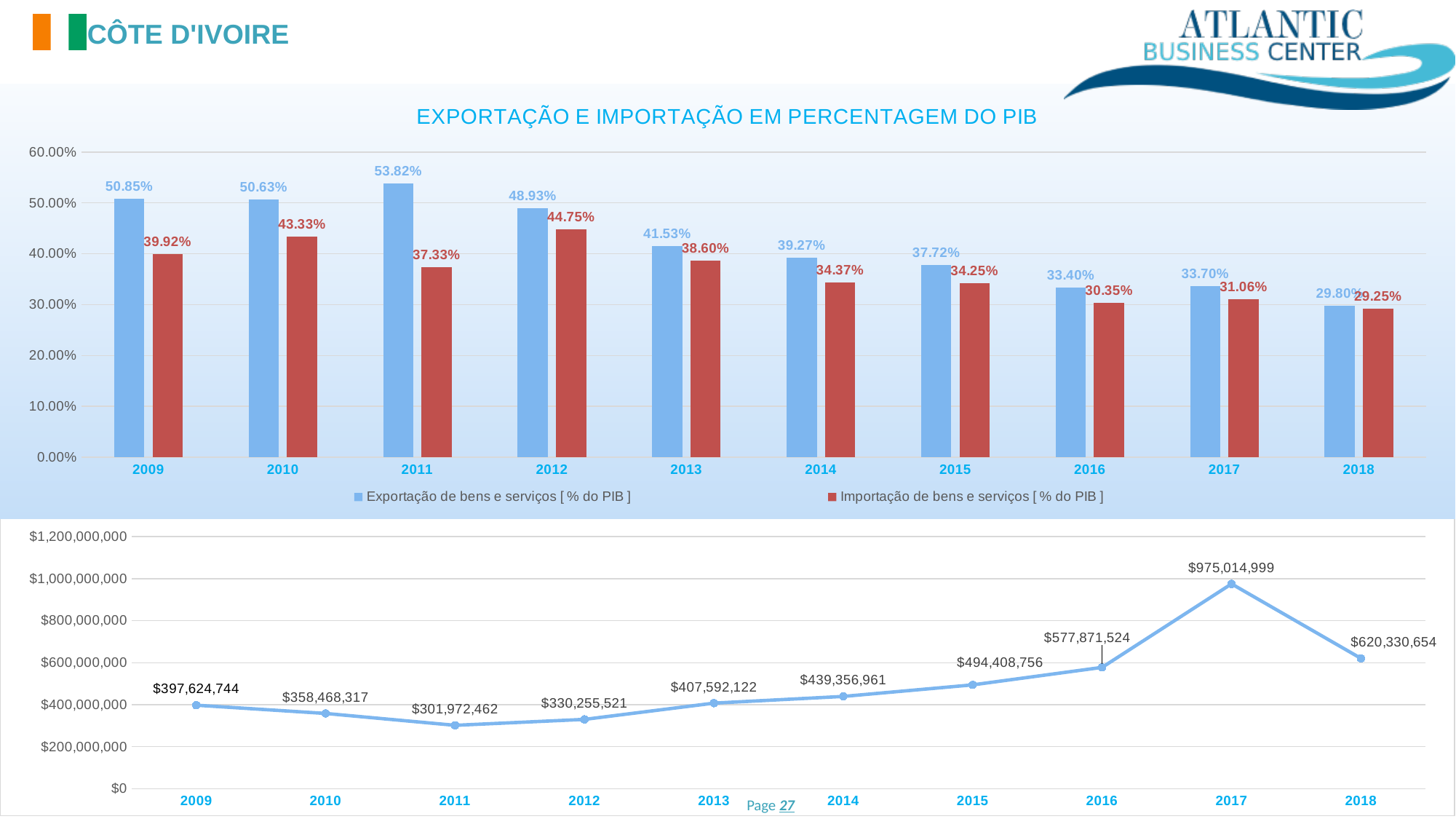
In the bottom line chart, what is the value for 2017? $975,014,999 In the chart titled 'EXPORTAÇÃO E IMPORTAÇÃO EM PERCENTAGEM DO PIB', which year has the highest Exportação de bens e serviços value? 2011 In the chart titled 'EXPORTAÇÃO E IMPORTAÇÃO EM PERCENTAGEM DO PIB', what is the value of Exportação de bens e serviços for 2011? 53.82% In the chart titled 'EXPORTAÇÃO E IMPORTAÇÃO EM PERCENTAGEM DO PIB', do the Exportação de bens e serviços values generally rise or fall from 2011 to 2018? Fall In the bottom line chart, how many years are plotted? 10 In the chart titled 'EXPORTAÇÃO E IMPORTAÇÃO EM PERCENTAGEM DO PIB', what is the difference between the Exportação and Importação values for 2011? 16.49% In the chart titled 'EXPORTAÇÃO E IMPORTAÇÃO EM PERCENTAGEM DO PIB', what kind of chart is shown? Bar chart In the chart titled 'EXPORTAÇÃO E IMPORTAÇÃO EM PERCENTAGEM DO PIB', what is the value of Importação de bens e serviços for 2012? 44.75% In the bottom line chart, is the value for 2016 greater or less than $600,000,000? less In the chart titled 'EXPORTAÇÃO E IMPORTAÇÃO EM PERCENTAGEM DO PIB', how many series does the legend list? 2 In the bottom line chart, which year has the lowest value? 2011 In the chart titled 'EXPORTAÇÃO E IMPORTAÇÃO EM PERCENTAGEM DO PIB', which year has the lowest Importação de bens e serviços value? 2018